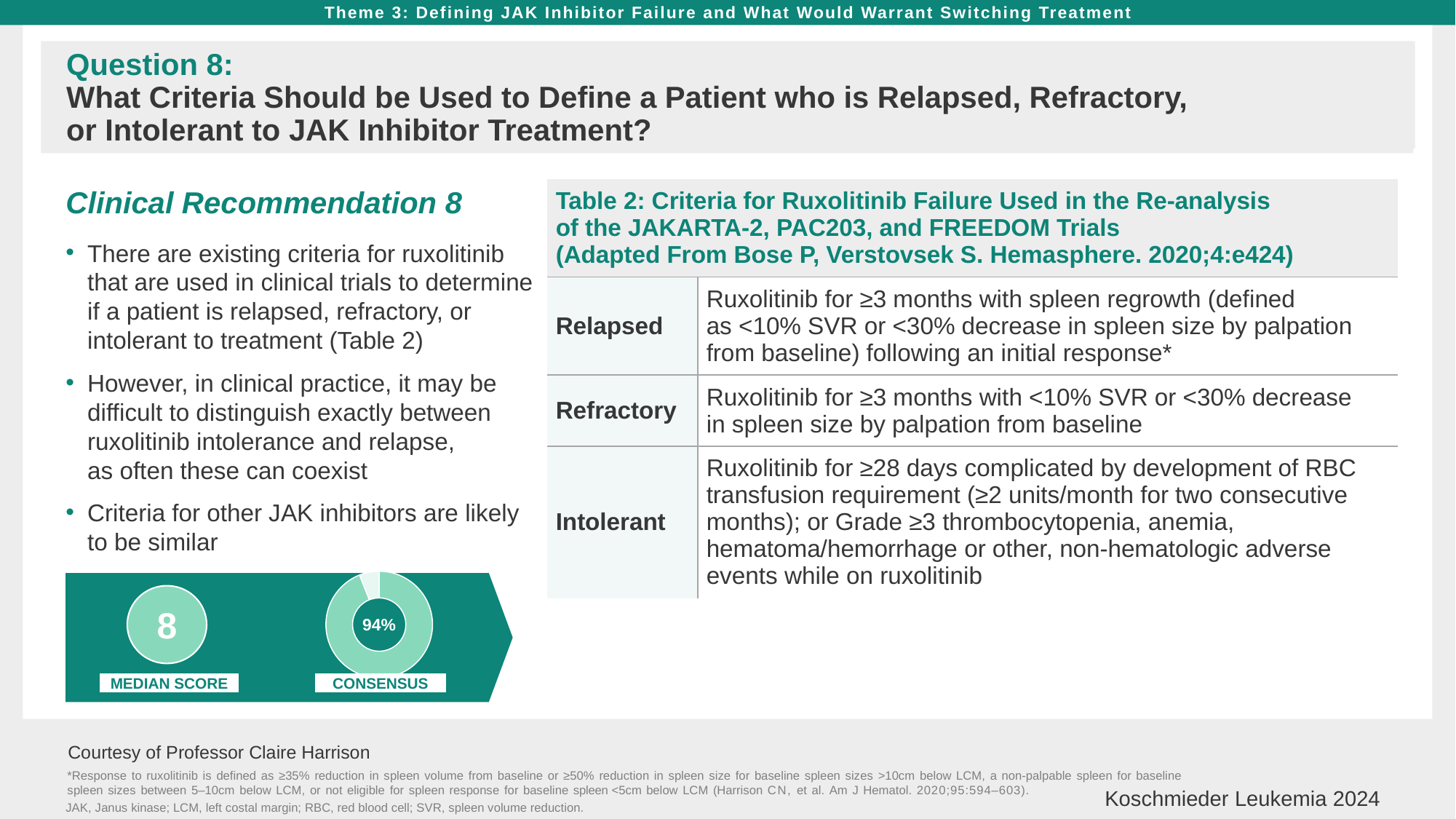
What consensus percentage is shown in the donut chart at the bottom left of the slide? 94% Which is larger in the bottom-left graphic: the consensus slice (94%) or the remaining slice of the donut? The consensus slice (94%) Is the consensus value shown in the donut chart greater or less than 90%? greater What kind of chart is used to display the consensus value on the slide? Donut (pie) chart What median score is shown in the circle graphic next to the consensus donut chart? 8 What share of the donut chart does the consensus slice represent? 94% What label appears beneath the donut chart showing 94%? CONSENSUS What share of the donut chart is not covered by the 94% consensus slice? 6%